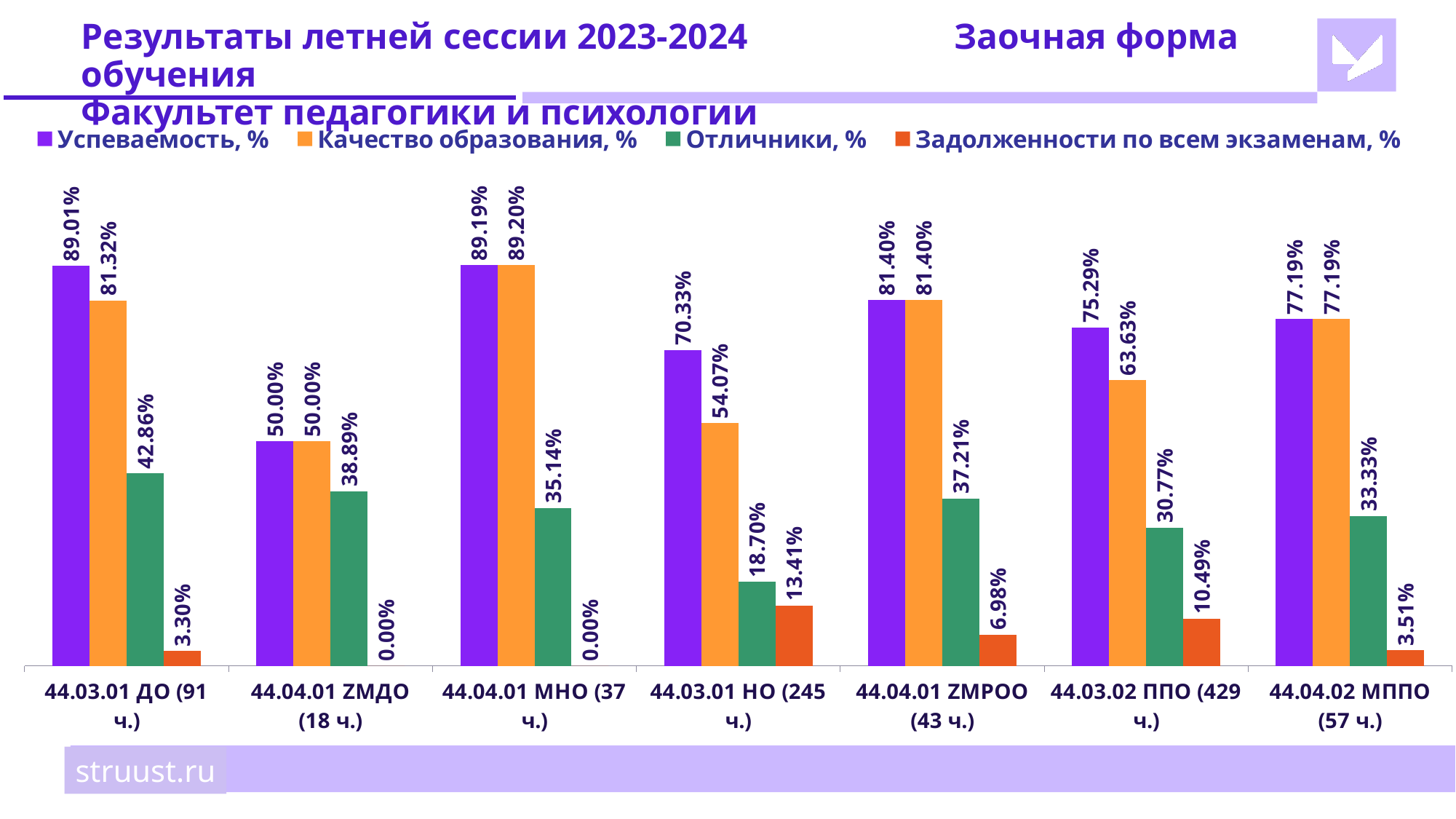
What is the difference between Успеваемость, % and Качество образования, % for 44.03.01 НО (245 ч.)? 16.26% How many series does the legend list? 4 How many categories are shown on the x axis? 7 Which category has the highest value for Отличники, %? 44.03.01 ДО (91 ч.) What is the value of Успеваемость, % for 44.03.01 НО (245 ч.)? 70.33% What is the value of Отличники, % for 44.04.01 МНО (37 ч.)? 35.14% What is the value of Задолженности по всем экзаменам, % for 44.04.01 ZМРОО (43 ч.)? 6.98% What kind of chart is shown on the slide? Bar chart Which category has the lowest value for Качество образования, %? 44.04.01 ZМДО (18 ч.) Which is larger for 44.03.02 ППО (429 ч.): Отличники, % or Задолженности по всем экзаменам, %? Отличники, % What is the value of Качество образования, % for 44.03.02 ППО (429 ч.)? 63.63% Which category has the highest value for Задолженности по всем экзаменам, %? 44.03.01 НО (245 ч.)